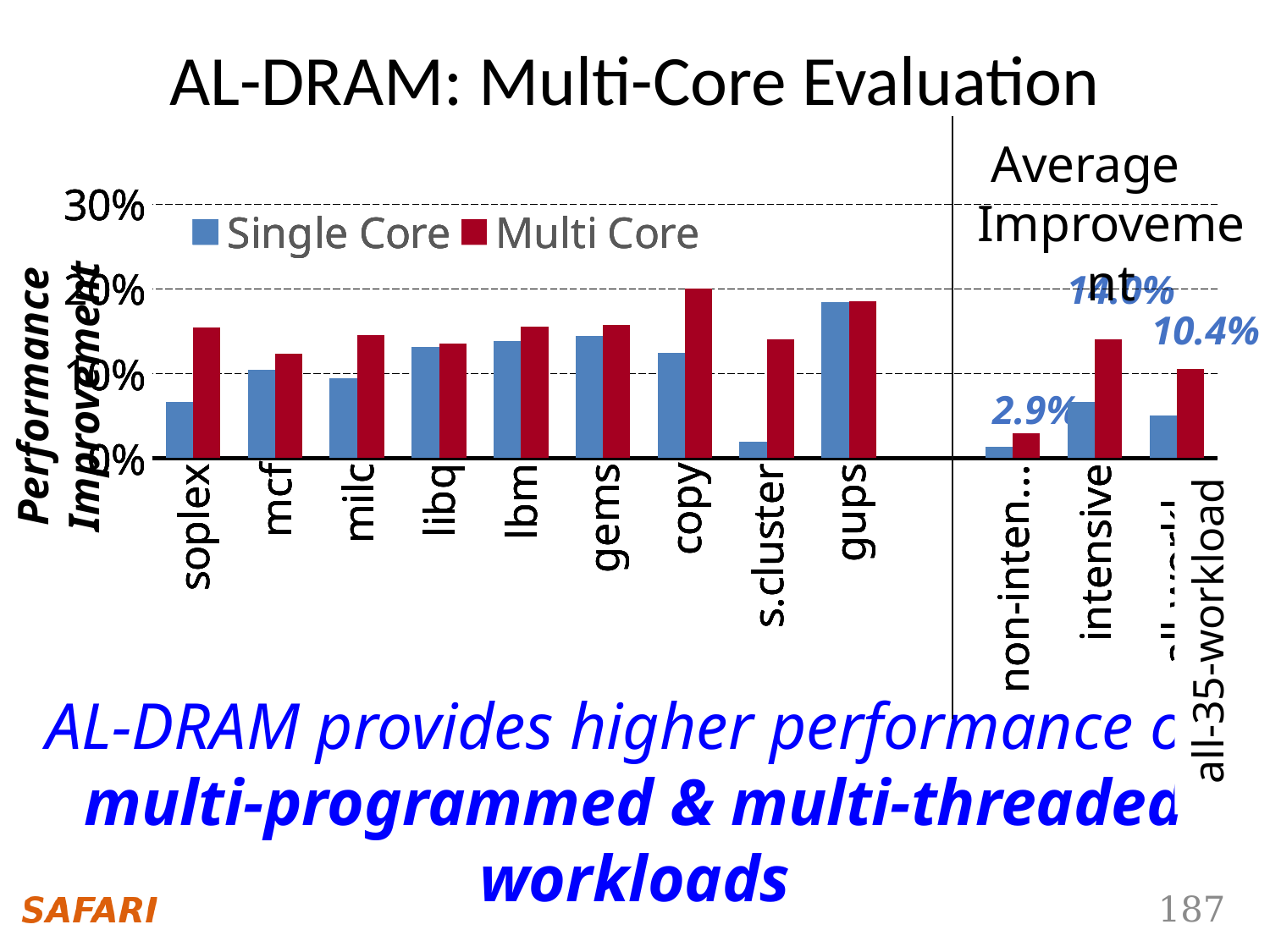
Is the Multi Core performance improvement for copy greater or less than 10%? greater Among the nine individual benchmarks (soplex through gups), which has the highest Multi Core performance improvement? copy Among the nine individual benchmarks (soplex through gups), which has the lowest Single Core performance improvement? s.cluster Among the nine individual benchmarks (soplex through gups), which has the highest Single Core performance improvement? gups What is the title of the slide's chart? AL-DRAM: Multi-Core Evaluation For soplex, which is larger: the Single Core or the Multi Core performance improvement? Multi Core What are the two series named in the legend? Single Core and Multi Core What is the labelled Multi Core performance improvement for all-35-workload? 10.4% What is the labelled Multi Core performance improvement for the non-intensive workloads? 2.9% How many series does the chart's legend list? 2 How many individual benchmarks are plotted to the left of the vertical divider line? 9 What kind of chart is shown on the slide? bar chart